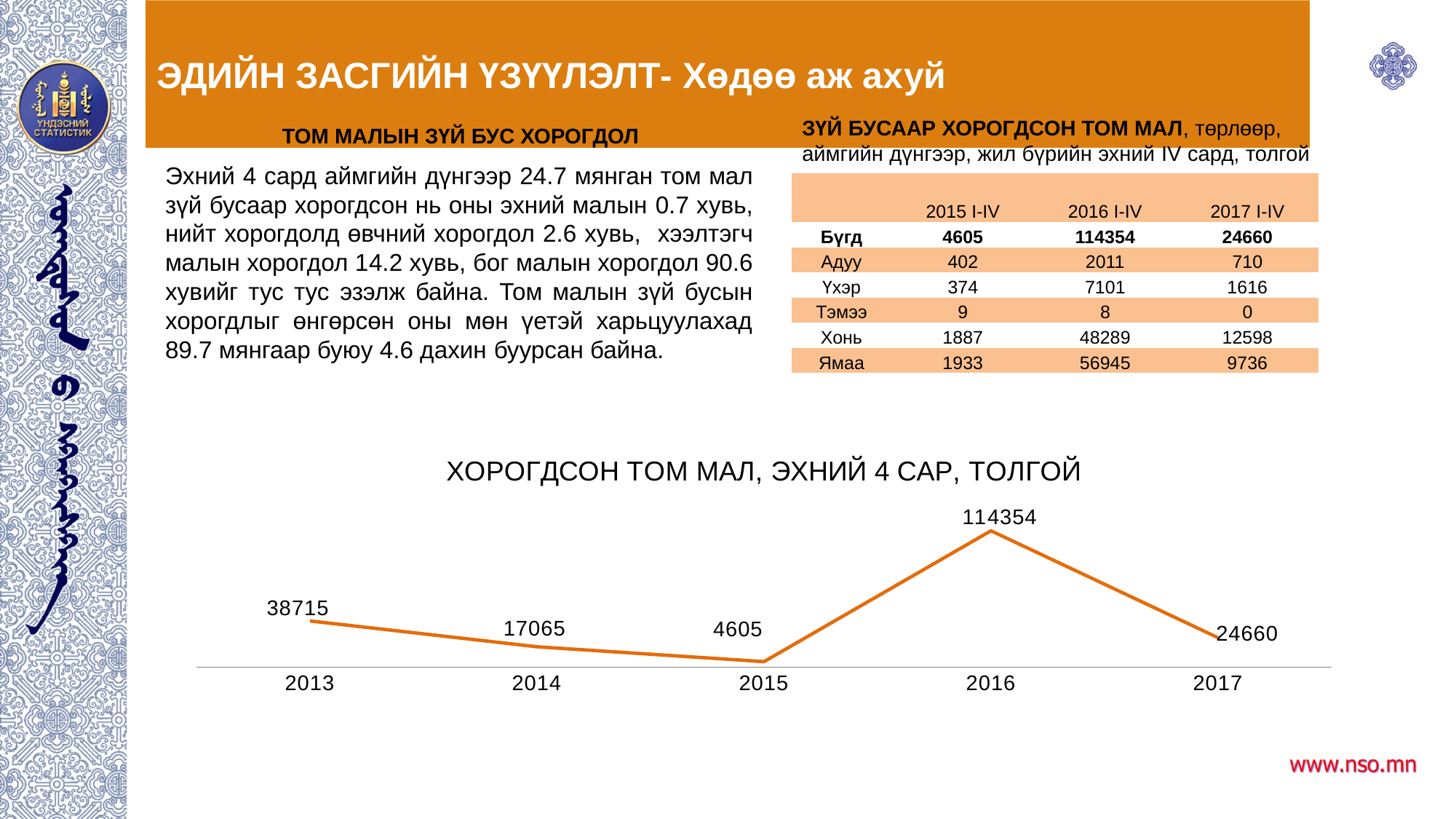
Which year has the lowest value in the chart? 2015 What is the value for 2016 in the chart 'ХОРОГДСОН ТОМ МАЛ, ЭХНИЙ 4 САР, ТОЛГОЙ'? 114354 Which year has the highest value in the chart? 2016 What is the value for 2013 in the chart? 38715 What is the value for 2015 in the chart? 4605 What is the value for 2017 in the chart? 24660 Which is larger in the chart, the value for 2013 or the value for 2017? 2013 Do the values in the chart rise or fall from 2013 to 2015? Fall How many years are plotted in the chart? 5 What kind of chart is shown on the slide? Line chart What is the difference between the values for 2013 and 2014 in the chart? 21650 What is the difference between the values for 2016 and 2017 in the chart? 89694